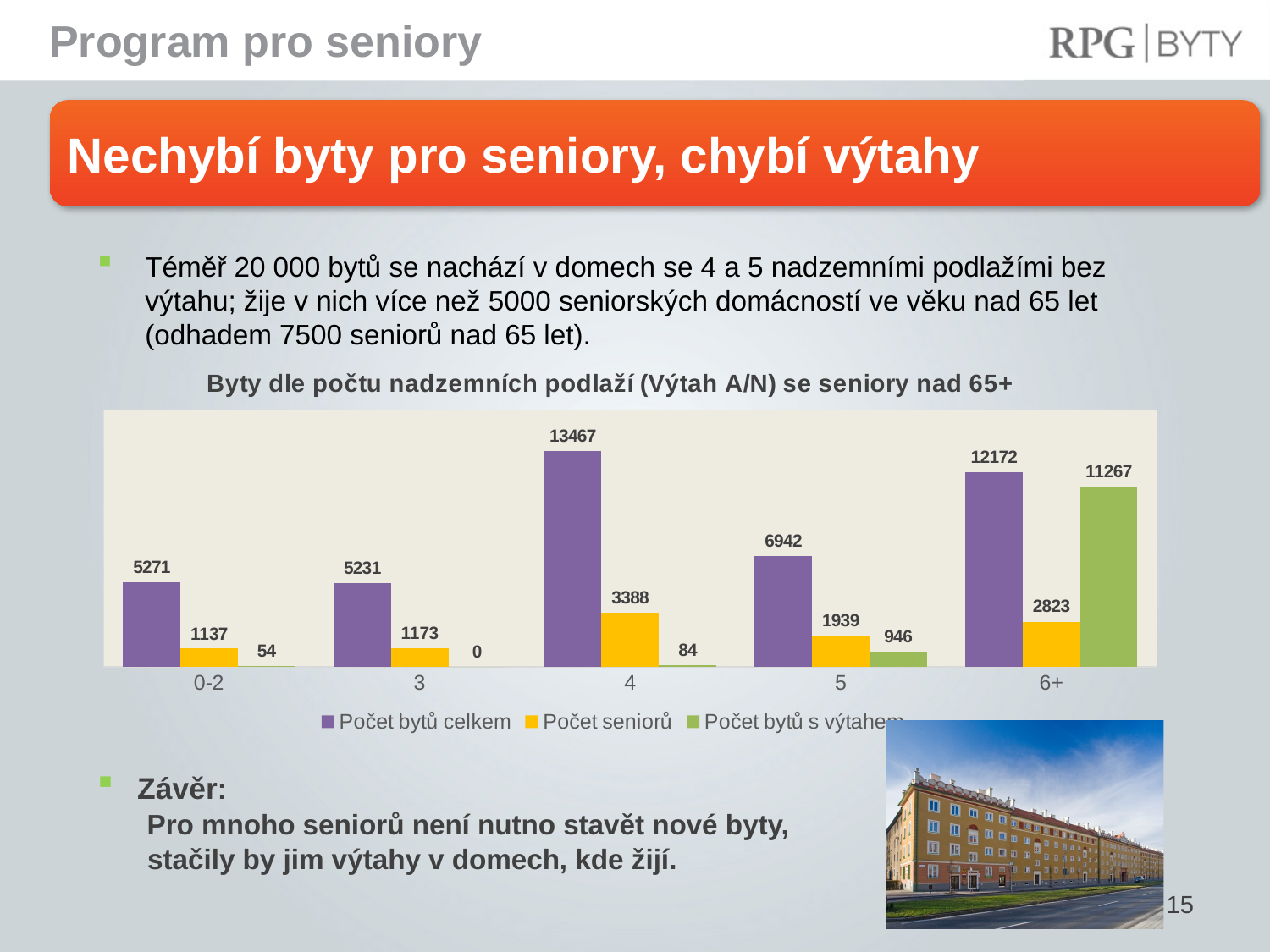
What is the value of 'Počet bytů s výtahem' for the category '3'? 0 What kind of chart is shown on the slide? bar chart Which category has the lowest value for 'Počet bytů s výtahem'? 3 Which category has the highest value for 'Počet bytů celkem'? 4 How many series does the legend list? 3 Which is larger: 'Počet seniorů' for category '4' or for category '5'? 4 What is the title of the chart? Byty dle počtu nadzemních podlaží (Výtah A/N) se seniory nad 65+ What is the total of 'Počet seniorů' across the categories '4' and '5'? 5327 How many categories are shown on the x axis? 5 What is the value of 'Počet bytů celkem' for the category '4'? 13467 What is the difference between 'Počet bytů celkem' and 'Počet bytů s výtahem' for the category '6+'? 905 What is the value of 'Počet seniorů' for the category '6+'? 2823